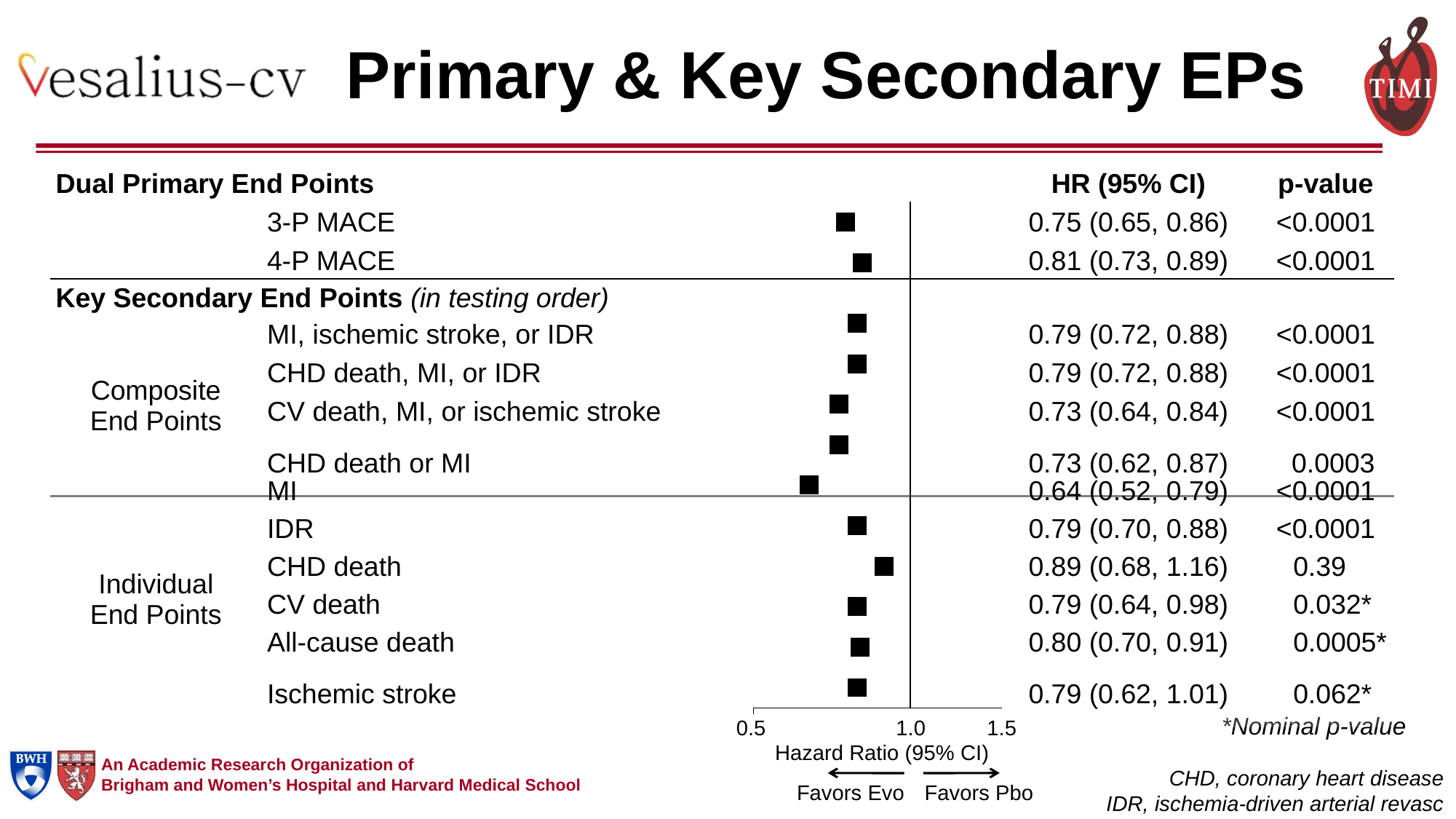
Is the hazard ratio for Ischemic stroke greater or less than 1.0? less What is the hazard ratio (95% CI) for MI? 0.64 (0.52, 0.79) What is the difference between the hazard ratios for 4-P MACE and 3-P MACE? 0.06 What is the label of the horizontal axis of the chart? Hazard Ratio (95% CI) What is the hazard ratio (95% CI) for All-cause death? 0.80 (0.70, 0.91) Which end point has the lowest hazard ratio? MI What kind of chart is shown on the slide? Forest plot How many end points are plotted on the chart? 12 Which has the larger hazard ratio, CHD death or CV death? CHD death Which end point has the highest hazard ratio? CHD death What is the p-value for CHD death? 0.39 What is the hazard ratio (95% CI) for 3-P MACE? 0.75 (0.65, 0.86)